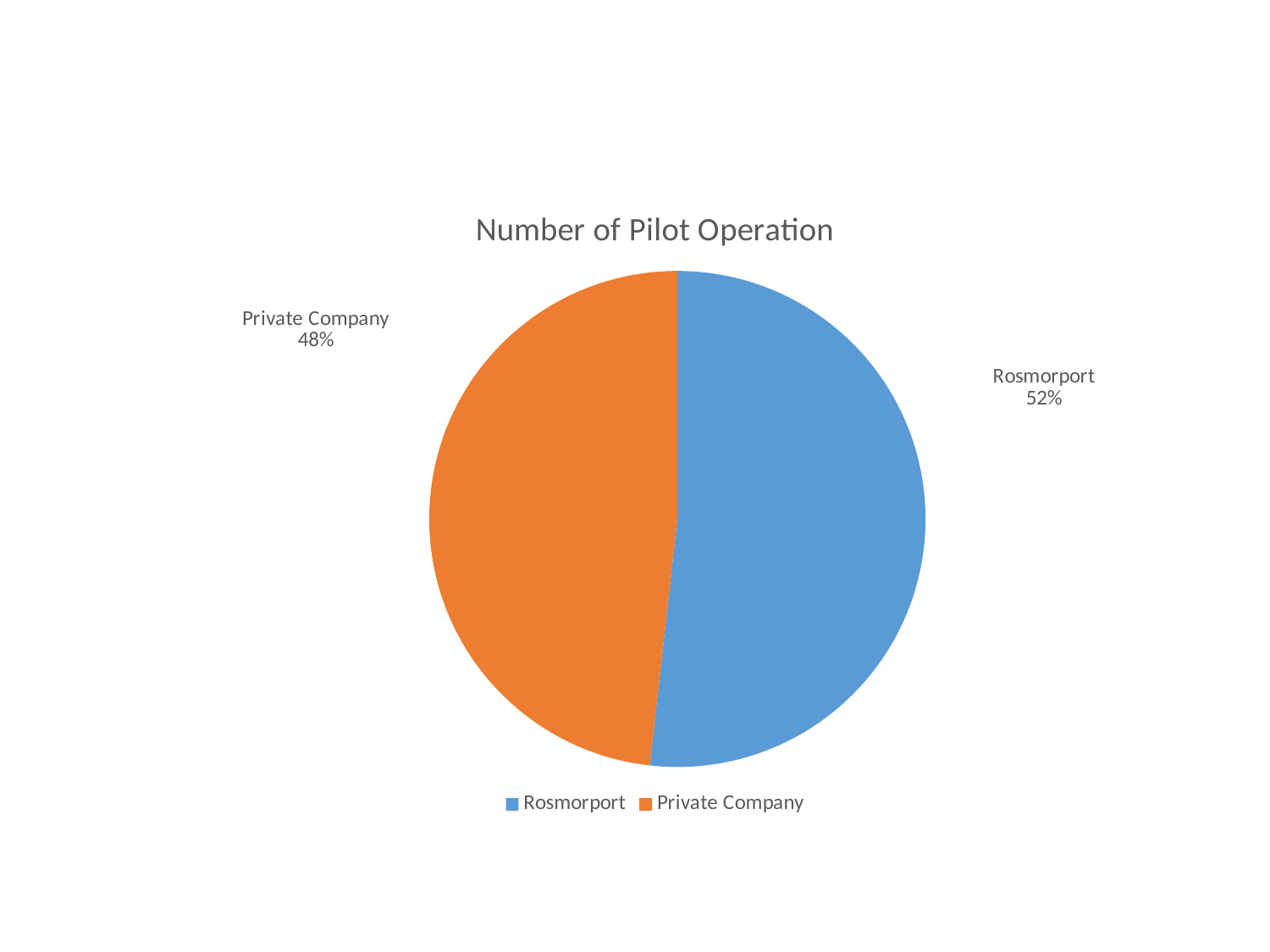
Which slice is the smallest? Private Company What kind of chart is shown on the slide? Pie chart What colour is the Private Company slice? Orange What is the difference in percentage points between the Rosmorport and Private Company slices? 4 percentage points What share of the pie does Private Company hold? 48% What share of the pie does Rosmorport hold? 52% Which is larger, the Rosmorport slice or the Private Company slice? Rosmorport How many slices does the pie chart have? 2 What is the title of the chart? Number of Pilot Operation Which slice is the largest? Rosmorport How many entries does the legend list? 2